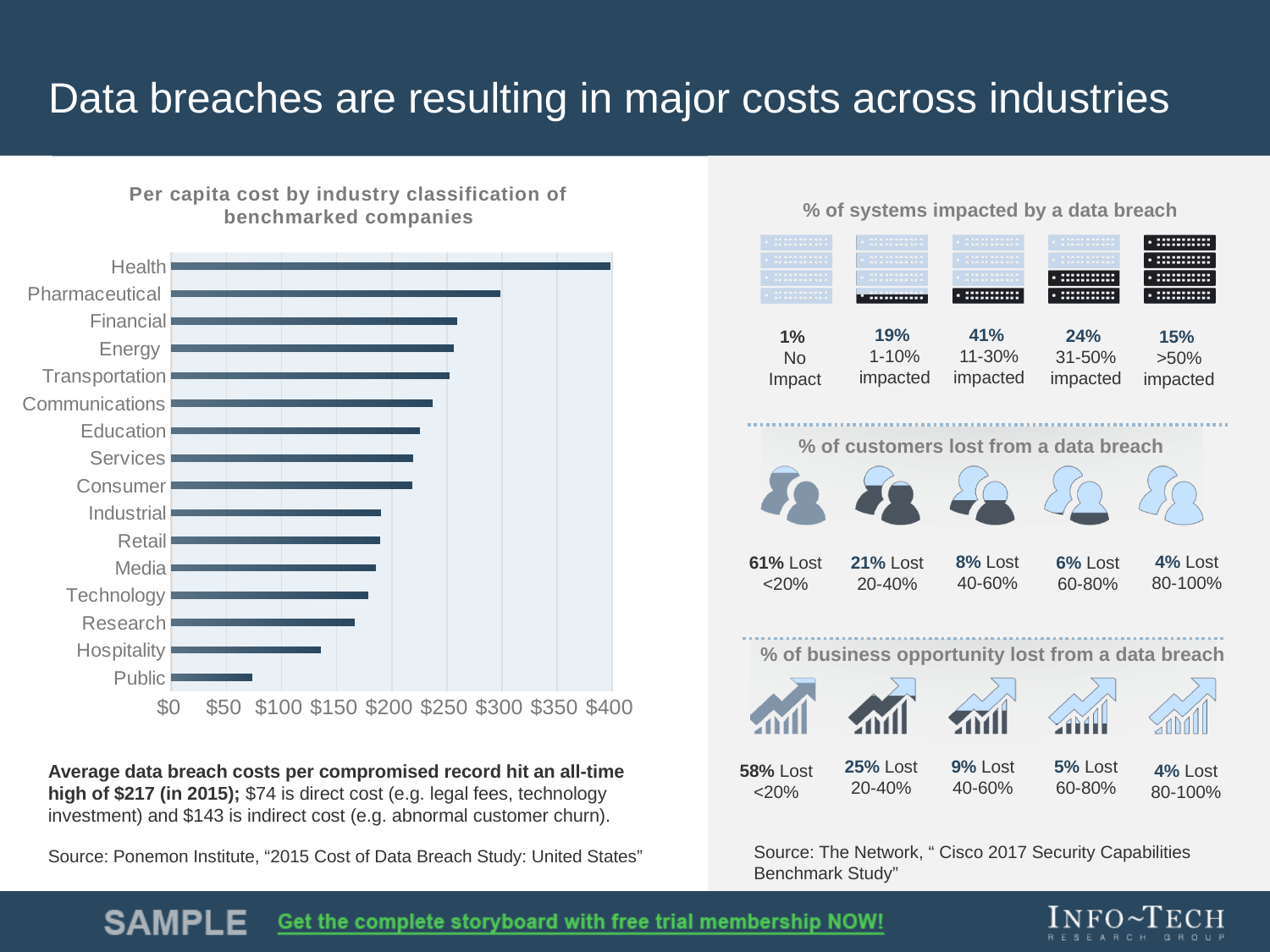
Which industry has the lowest per capita cost in the bar chart? Public Is the per capita cost for Hospitality greater or less than $150? less What is the title of the bar chart on the left of the slide? Per capita cost by industry classification of benchmarked companies Is the per capita cost for Pharmaceutical greater or less than $250? greater Is the per capita cost for Health greater or less than $350? greater Which has a higher per capita cost, Pharmaceutical or Financial? Pharmaceutical Which industry has the highest per capita cost in the bar chart? Health Which has a higher per capita cost, Research or Hospitality? Research How many industries are shown in the per capita cost bar chart? 16 What type of chart is used to show per capita cost by industry classification? Bar chart